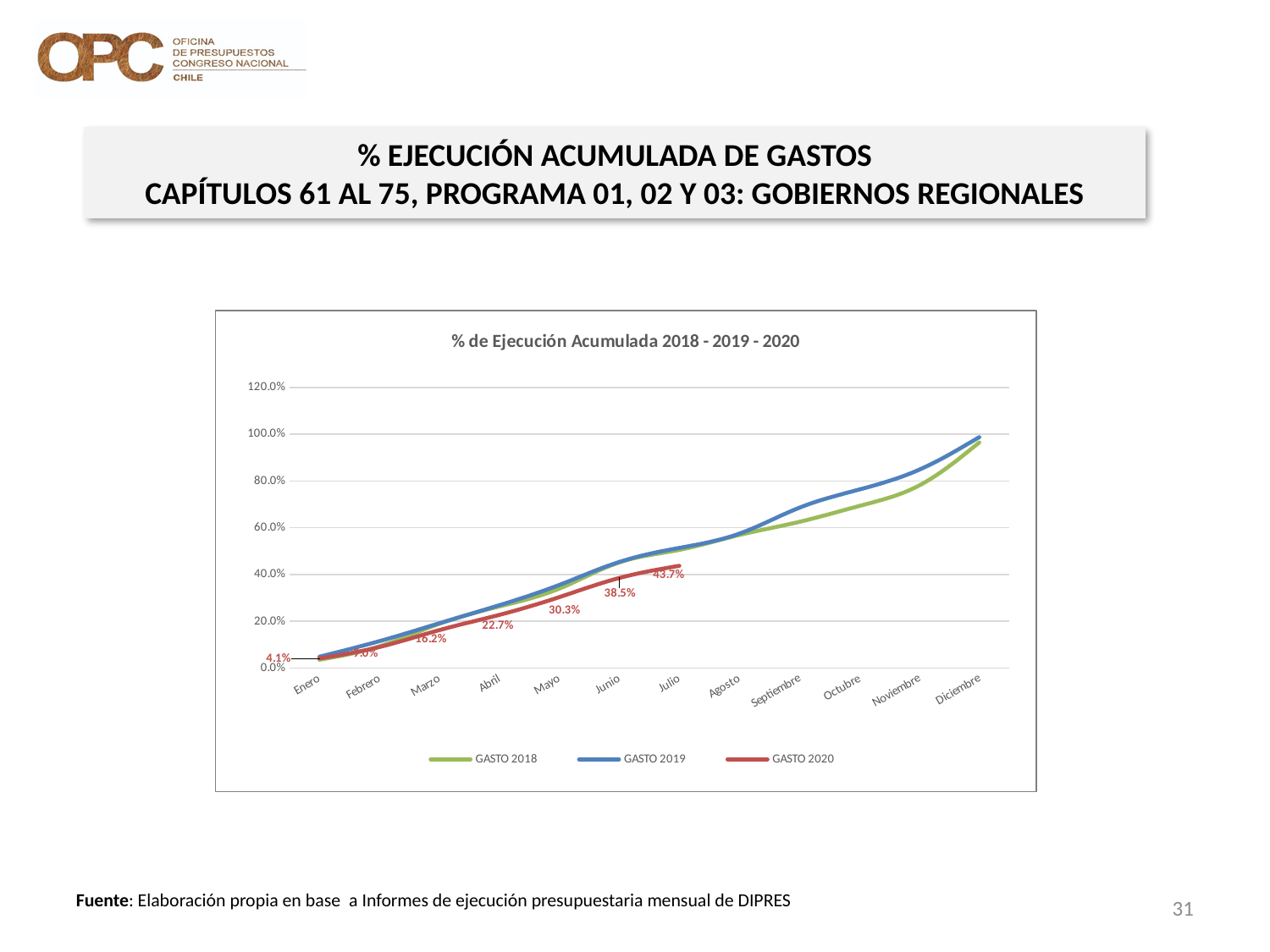
What is the value for GASTO 2020 in Marzo? 16.2% How many months are shown along the x axis of the chart? 12 What kind of chart is shown on the slide? line chart Is the value for GASTO 2018 in Septiembre greater or less than 80.0%? less Which month has the highest labelled value for GASTO 2020? Julio What is the value for GASTO 2020 in Junio? 38.5% What is the value for GASTO 2020 in Abril? 22.7% What is the value for GASTO 2020 in Julio? 43.7% Do the GASTO 2019 values rise or fall from Enero to Diciembre? rise What is the title of the chart? % de Ejecución Acumulada 2018 - 2019 - 2020 How many series does the chart legend list? 3 What is the difference between the GASTO 2020 values for Julio and Junio? 5.2%